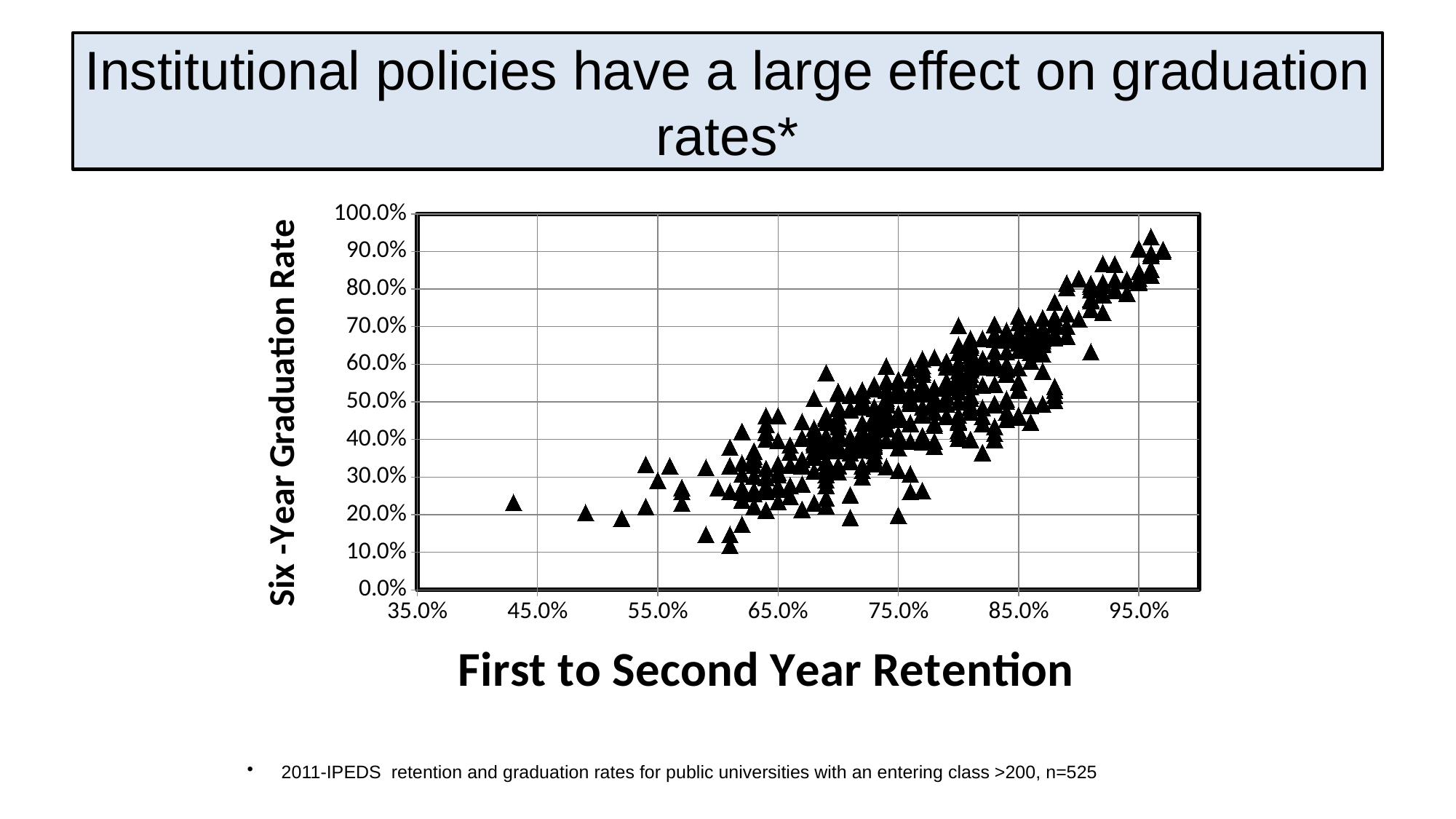
What is the lowest value labelled on the x axis? 35.0% What is the title of the chart's y axis? Six -Year Graduation Rate As first to second year retention increases along the x axis, does the six-year graduation rate generally rise or fall? rise What is the highest value labelled on the y axis? 100.0% How many tick labels are shown on the y axis? 11 Is the six-year graduation rate of the leftmost point (near 43% retention) greater or less than 30.0%? less What is the highest value labelled on the x axis? 95.0% What kind of chart is shown on the slide? scatter plot Are the points with retention above 90.0% mostly above or below a 70.0% graduation rate? above Is the six-year graduation rate of the lowest point on the chart greater or less than 20.0%? less How many tick labels are shown on the x axis? 7 What is the title of the chart's x axis? First to Second Year Retention